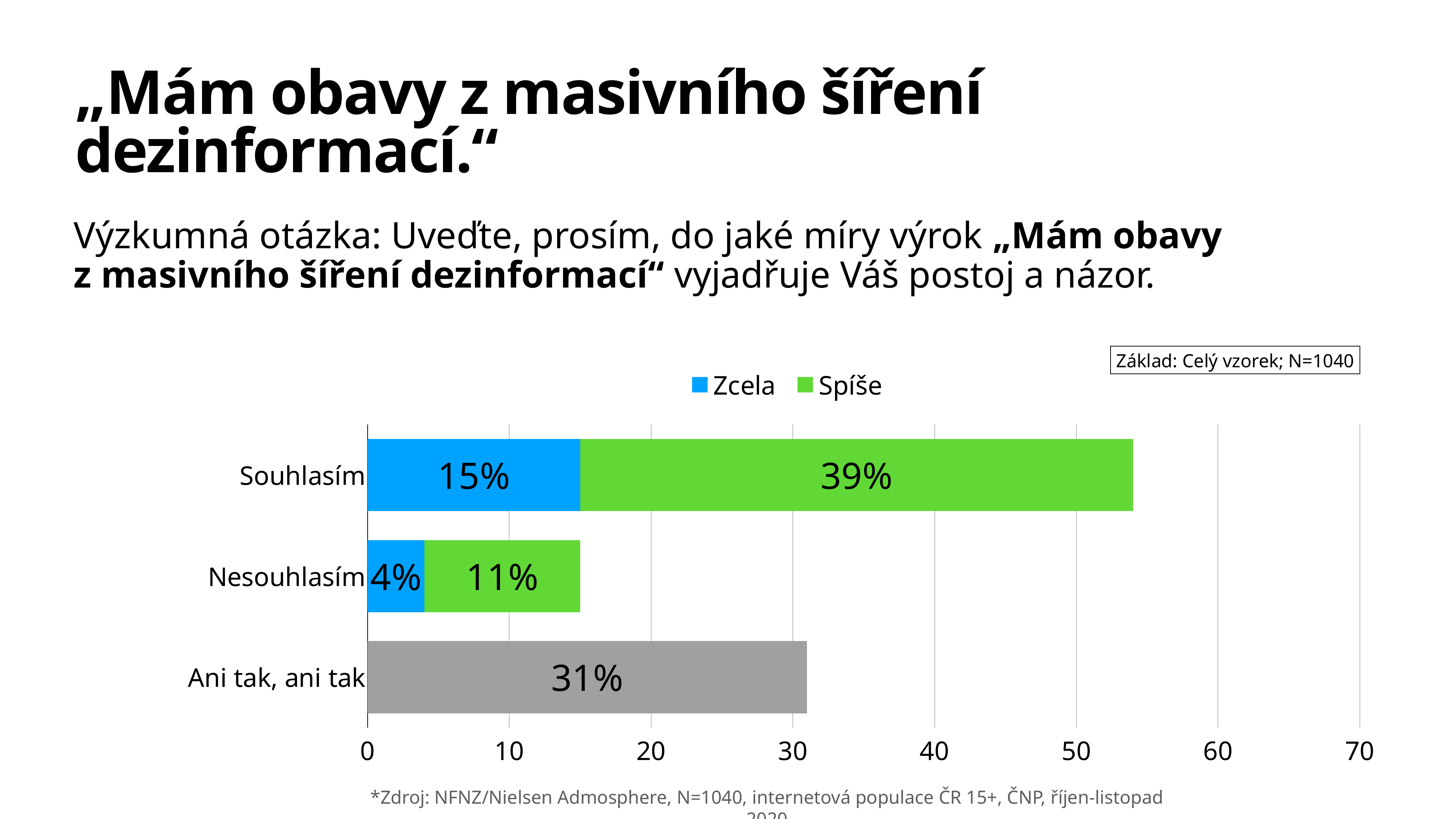
What is the total of the stacked bar for "Nesouhlasím"? 15% What is the "Zcela" value for "Souhlasím"? 15% What kind of chart is shown on the slide? Stacked bar chart How many categories are shown on the vertical axis of the chart? 3 What is the "Zcela" value for "Nesouhlasím"? 4% What is the value shown for "Ani tak, ani tak"? 31% Which is larger: the "Zcela" value for "Souhlasím" or the "Zcela" value for "Nesouhlasím"? Souhlasím What is the "Spíše" value for "Souhlasím"? 39% What is the difference between the "Spíše" values for "Souhlasím" and "Nesouhlasím"? 28% What is the "Spíše" value for "Nesouhlasím"? 11% What is the total of the stacked bar for "Souhlasím"? 54% How many series does the chart legend list? 2